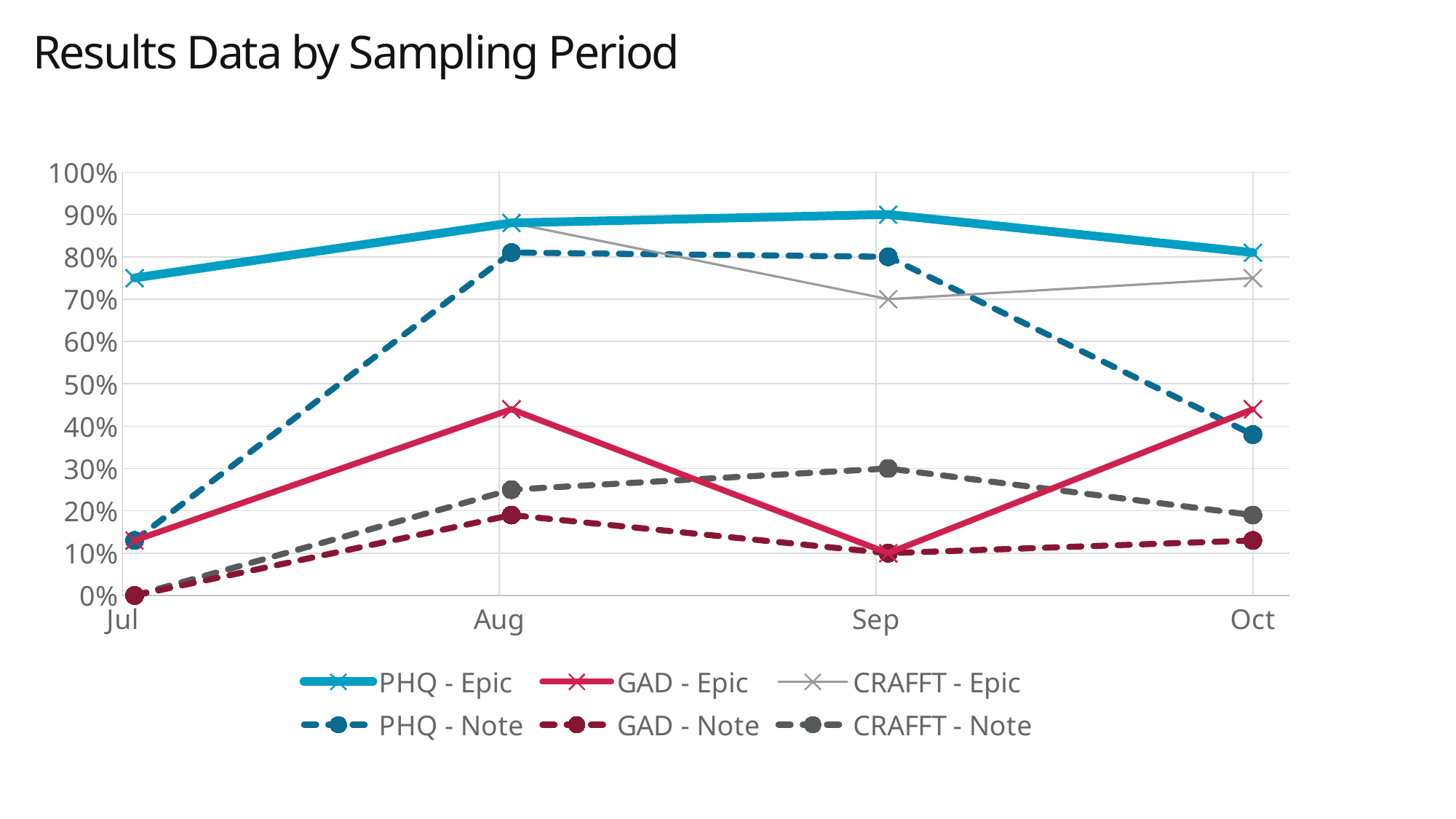
How many sampling periods are shown on the x axis? 4 What is the value for GAD - Note in Jul? 0% What is the value for CRAFFT - Note in Sep? 30% In which month is PHQ - Epic highest? Sep In which month is PHQ - Epic lowest? Jul What is the value for PHQ - Epic in Sep? 90% Which is larger in Oct, PHQ - Epic or PHQ - Note? PHQ - Epic Does PHQ - Note rise or fall from Sep to Oct? Fall What type of chart is shown on the slide? Line chart Is the value for PHQ - Note in Jul greater or less than 20%? less What is the value for CRAFFT - Epic in Sep? 70% How many series does the legend list? 6